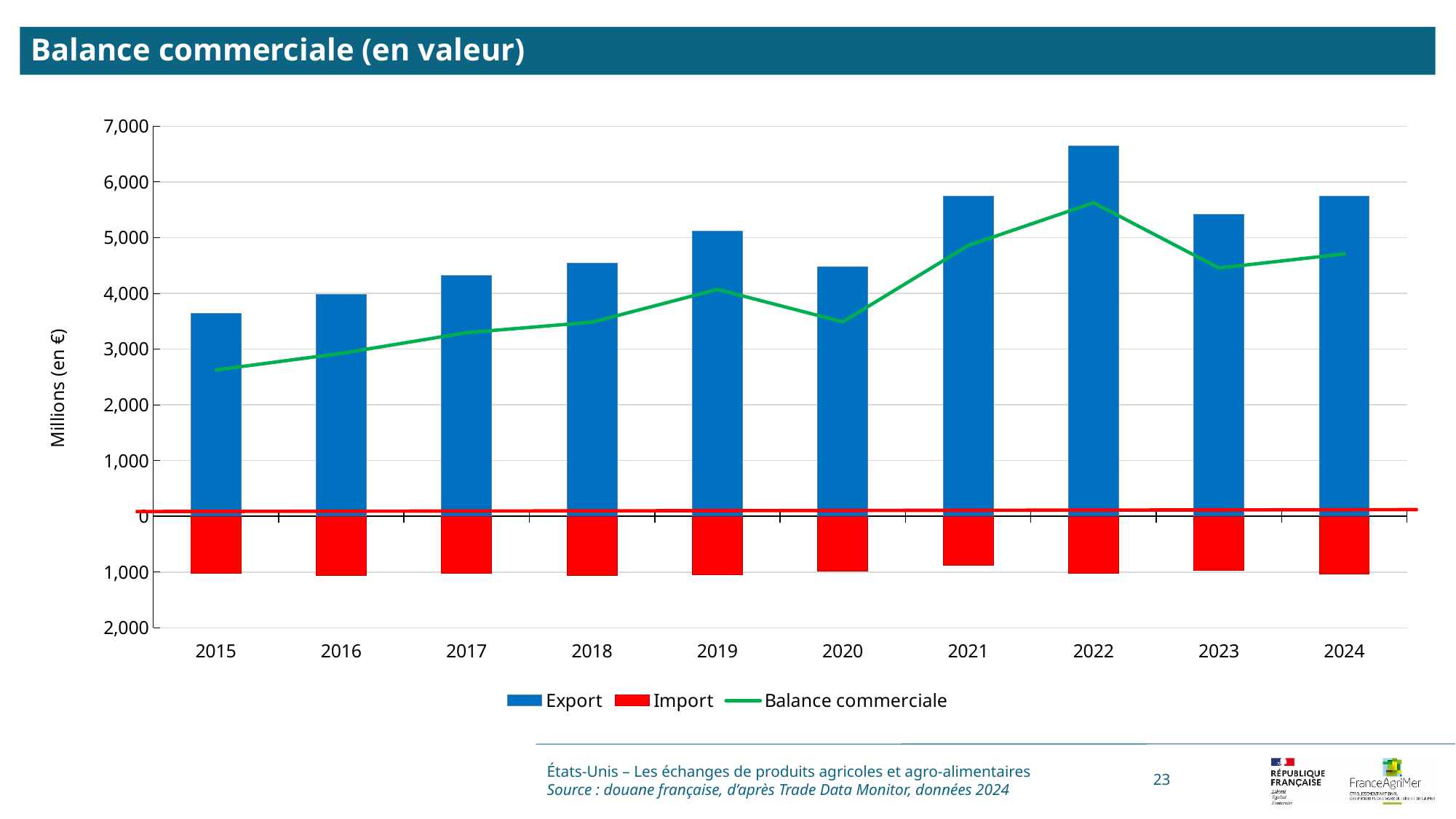
Is the Export value for 2022 greater or less than 6,000? greater How many series does the legend list? 3 Which year has the larger Export value, 2019 or 2020? 2019 Does the Balance commerciale line rise or fall between 2015 and 2022? rise In which year does the Balance commerciale line reach its highest point? 2022 What colour are the Import bars? Red How many years are shown on the x axis? 10 In which year is the Export bar lowest? 2015 Is the Export value for 2021 greater or less than 5,000? greater In which year is the Export bar highest? 2022 What unit is shown on the y axis label? Millions (en €) Is the Export value for 2015 greater or less than 4,000? less